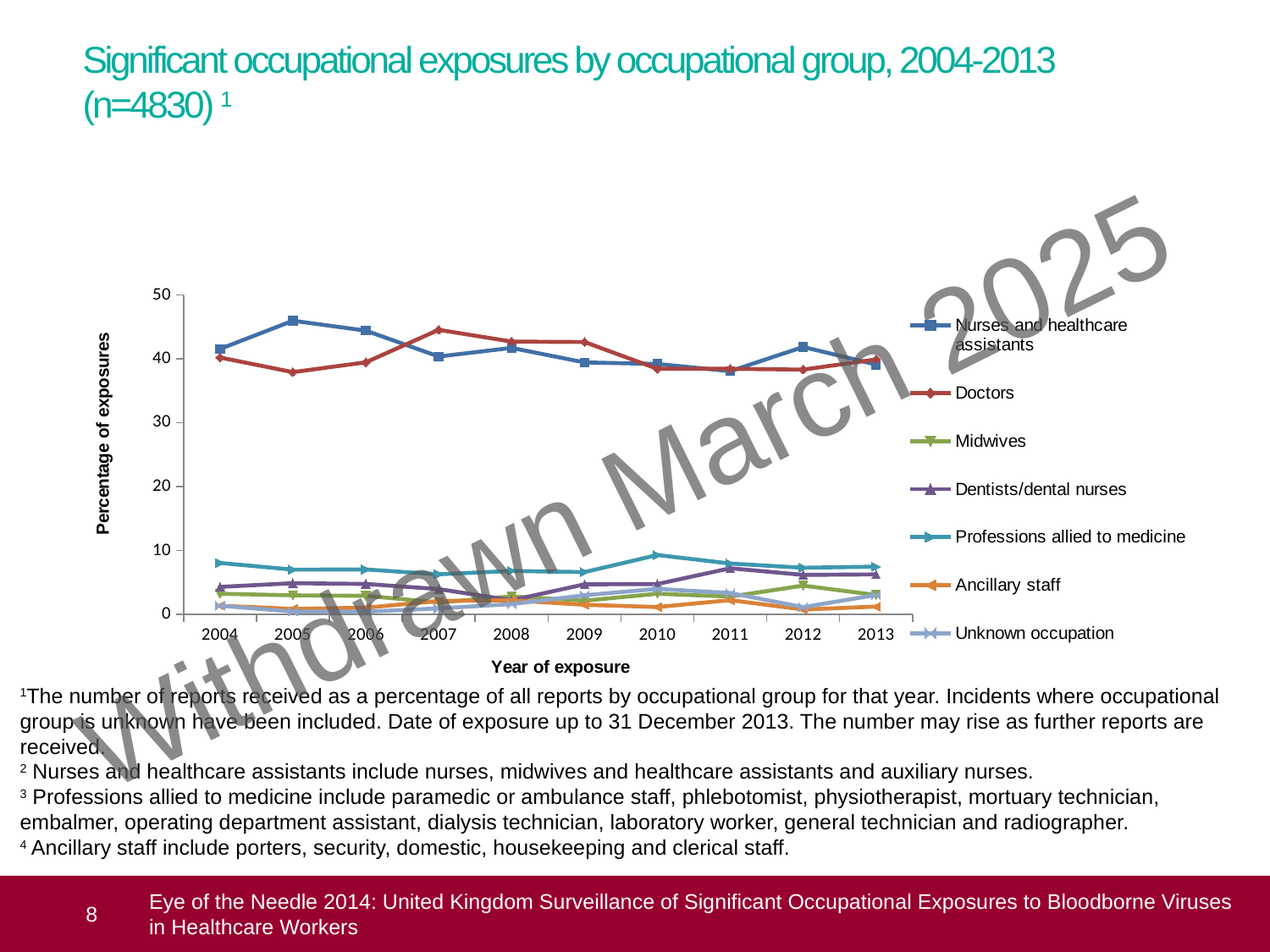
How many years are plotted along the x axis? 10 In which year does the Nurses and healthcare assistants line reach its highest value? 2005 In 2005, which is higher: Nurses and healthcare assistants or Doctors? Nurses and healthcare assistants How many series does the legend list? 7 Is the value for Nurses and healthcare assistants in 2005 greater or less than 40? greater Does the Nurses and healthcare assistants line rise or fall from 2005 to 2009? Fall What kind of chart is shown on the slide? Line chart Is the value for Doctors in 2005 greater or less than 40? less In 2007, which is higher: Doctors or Nurses and healthcare assistants? Doctors Is the value for Professions allied to medicine in 2010 greater or less than 10? less What is the label on the y axis of the chart? Percentage of exposures In 2004, which is higher: Professions allied to medicine or Dentists/dental nurses? Professions allied to medicine